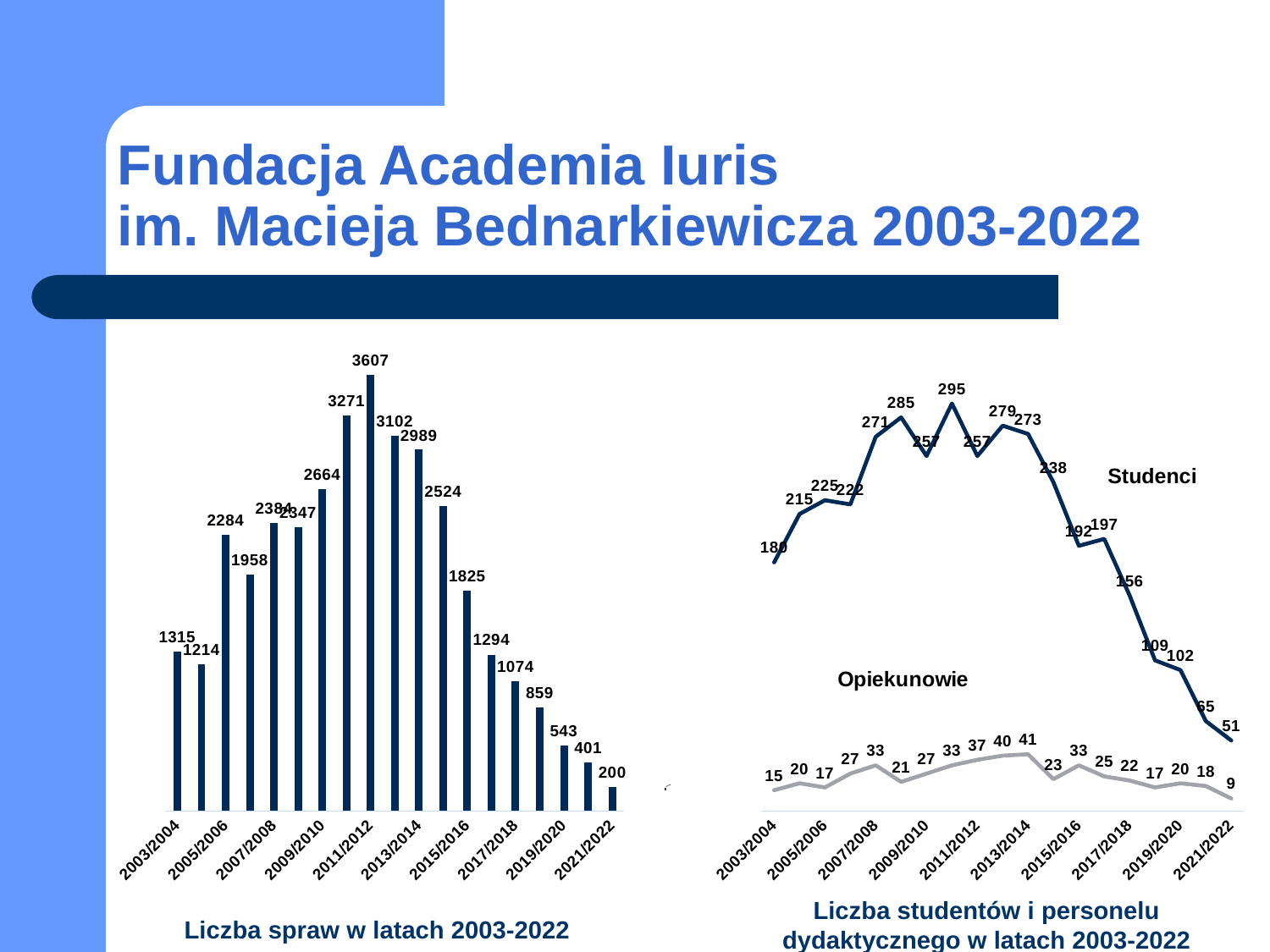
On the chart titled 'Liczba studentów i personelu dydaktycznego w latach 2003-2022', what is the Opiekunowie value for 2021/2022? 9 On the chart titled 'Liczba studentów i personelu dydaktycznego w latach 2003-2022', which year has the highest Opiekunowie value? 2013/2014 On the chart titled 'Liczba spraw w latach 2003-2022', what is the difference between the values for 2003/2004 and 2005/2006? 969 On the chart titled 'Liczba studentów i personelu dydaktycznego w latach 2003-2022', what is the Studenci value for 2011/2012? 257 On the chart titled 'Liczba spraw w latach 2003-2022', what kind of chart is shown? Bar chart On the chart titled 'Liczba spraw w latach 2003-2022', what is the value for 2011/2012? 3607 On the chart titled 'Liczba spraw w latach 2003-2022', how many bars are plotted? 19 On the chart titled 'Liczba spraw w latach 2003-2022', what is the value for 2021/2022? 200 On the chart titled 'Liczba spraw w latach 2003-2022', which year has the highest value? 2011/2012 On the chart titled 'Liczba studentów i personelu dydaktycznego w latach 2003-2022', is the Studenci value for 2003/2004 larger or smaller than the Studenci value for 2021/2022? Larger On the chart titled 'Liczba spraw w latach 2003-2022', which year has the lowest value? 2021/2022 On the chart titled 'Liczba studentów i personelu dydaktycznego w latach 2003-2022', how many series are plotted? 2